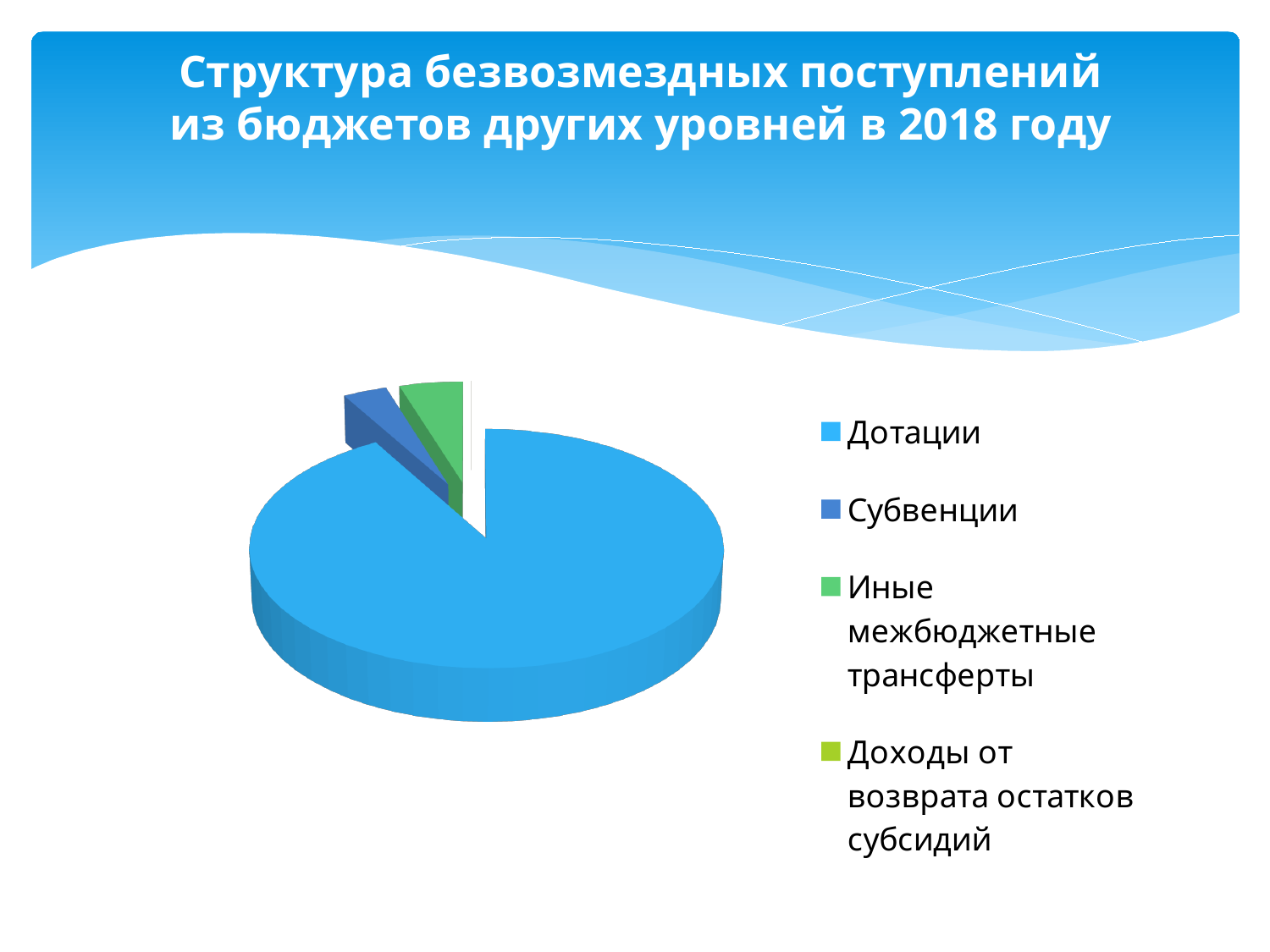
Which year does the chart title refer to? 2018 What kind of chart is shown on the slide? pie chart What is the title of the chart? Структура безвозмездных поступлений из бюджетов других уровней в 2018 году How many entries does the legend list? 4 Which is larger, the slice for Дотации or the slice for Иные межбюджетные трансферты? Дотации Which is larger, the slice for Дотации or the slice for Субвенции? Дотации Which category has the largest slice of the pie? Дотации Which legend entry is shown in light blue? Дотации